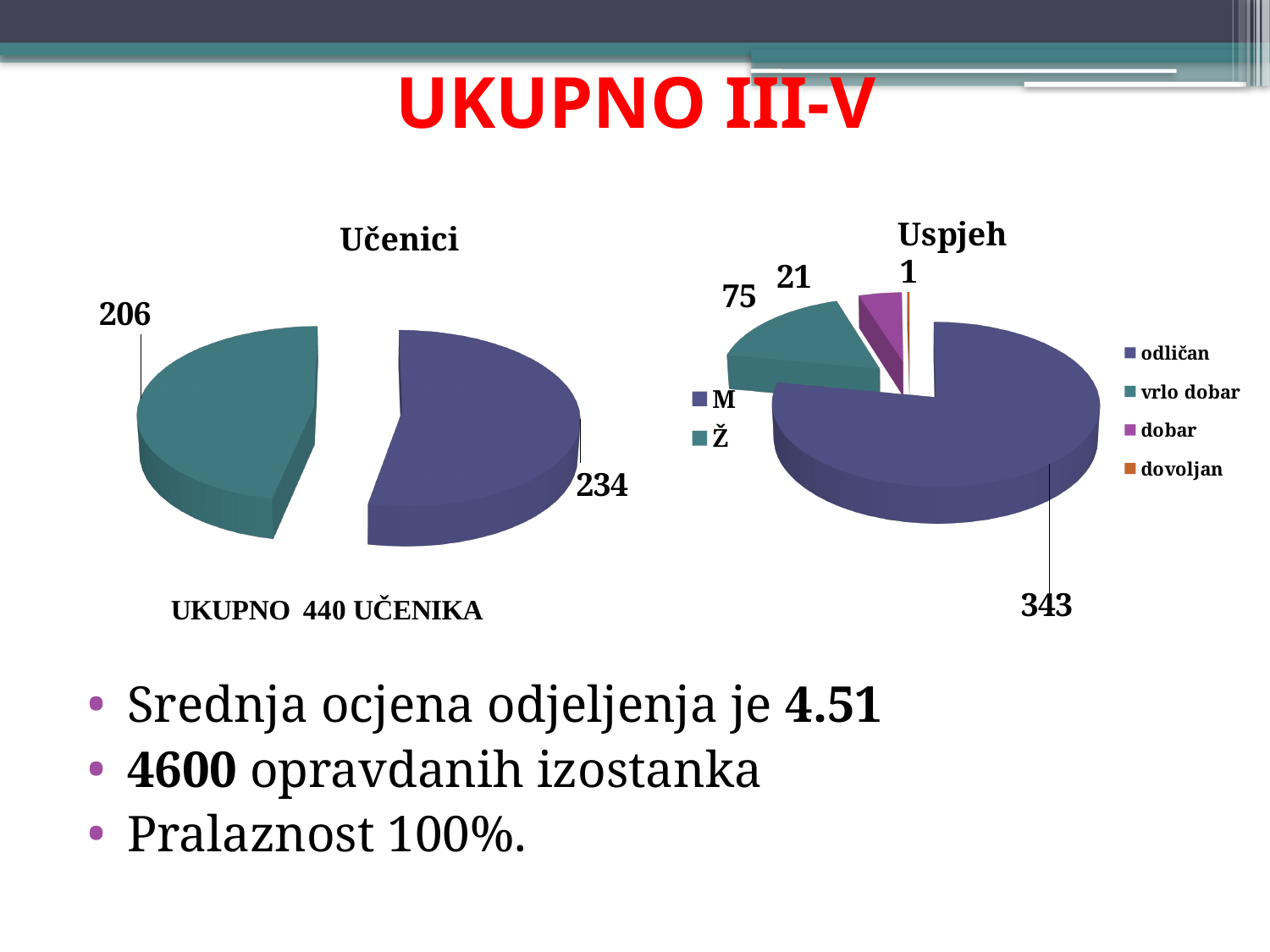
In the Uspjeh chart, what is the value for odličan? 343 In the Uspjeh chart, what is the value for dobar? 21 In the Uspjeh chart, which category has the lowest value? dovoljan In the Učenici chart, what is the value for Ž? 206 What kind of chart is the Učenici chart? pie chart In the Učenici chart, what is the value for M? 234 In the Učenici chart, which category is larger, M or Ž? M How many categories does the Uspjeh chart's legend list? 4 In the Učenici chart, what is the difference between the values for M and Ž? 28 In the Uspjeh chart, what is the value for vrlo dobar? 75 In the Uspjeh chart, which category has the highest value? odličan In the Uspjeh chart, what is the difference between the values for vrlo dobar and dobar? 54